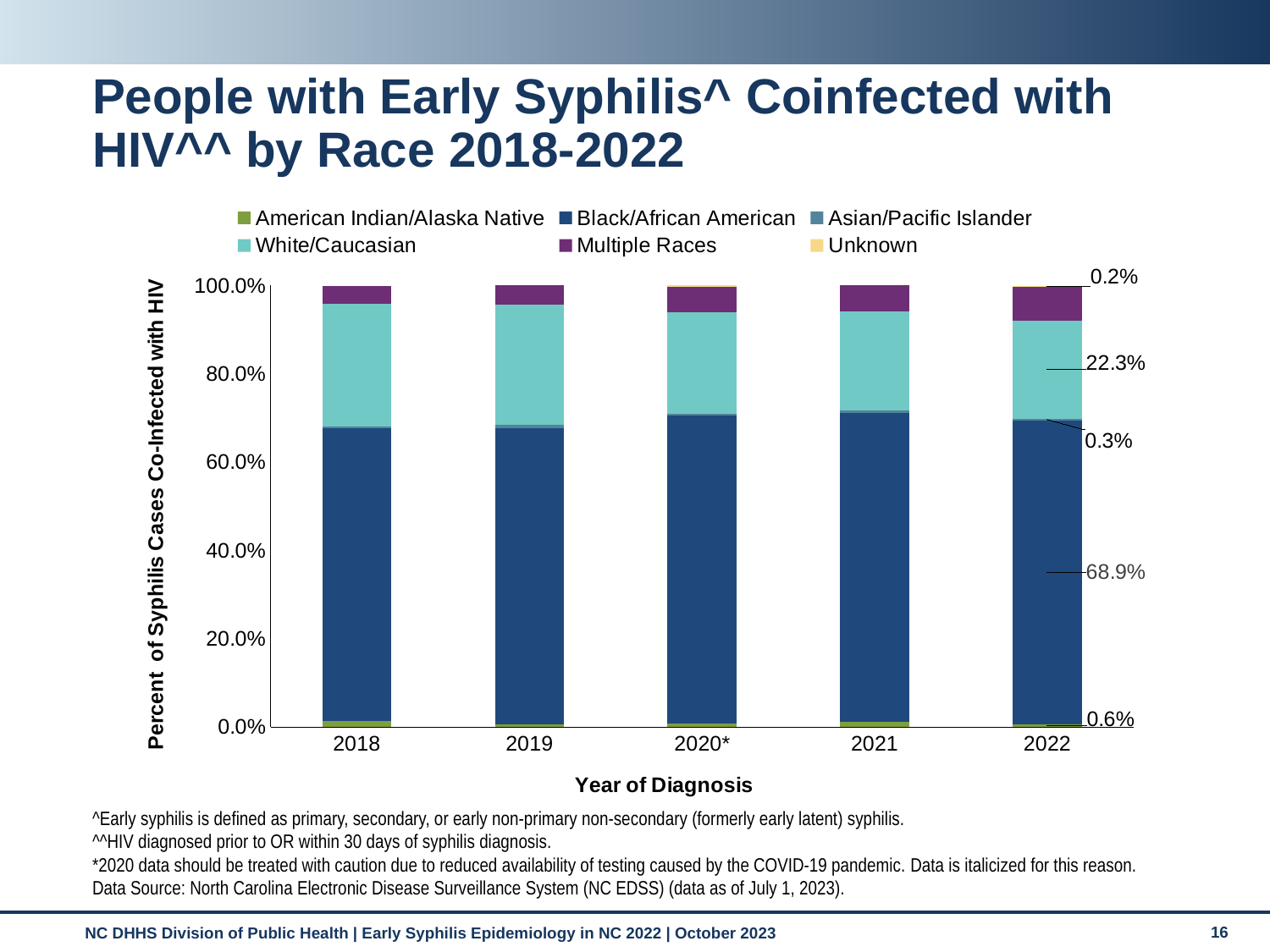
What kind of chart is shown on the slide? Stacked bar chart How many series does the chart's legend list? 6 What percentage of syphilis cases co-infected with HIV in 2022 were Black/African American? 68.9% What percentage of syphilis cases co-infected with HIV in 2022 were American Indian/Alaska Native? 0.6% What is the title of the chart's x axis? Year of Diagnosis How many years are shown on the x axis of the chart? 5 In 2022, how many percentage points higher is the Black/African American share than the White/Caucasian share? 46.6 percentage points What percentage of syphilis cases co-infected with HIV in 2022 were Asian/Pacific Islander? 0.3% What percentage of syphilis cases co-infected with HIV in 2022 were White/Caucasian? 22.3% Is the White/Caucasian share in 2020* greater or less than 40.0%? less Is the Black/African American share in 2018 greater or less than 60.0%? greater In 2022, which group has the larger share: Black/African American or White/Caucasian? Black/African American